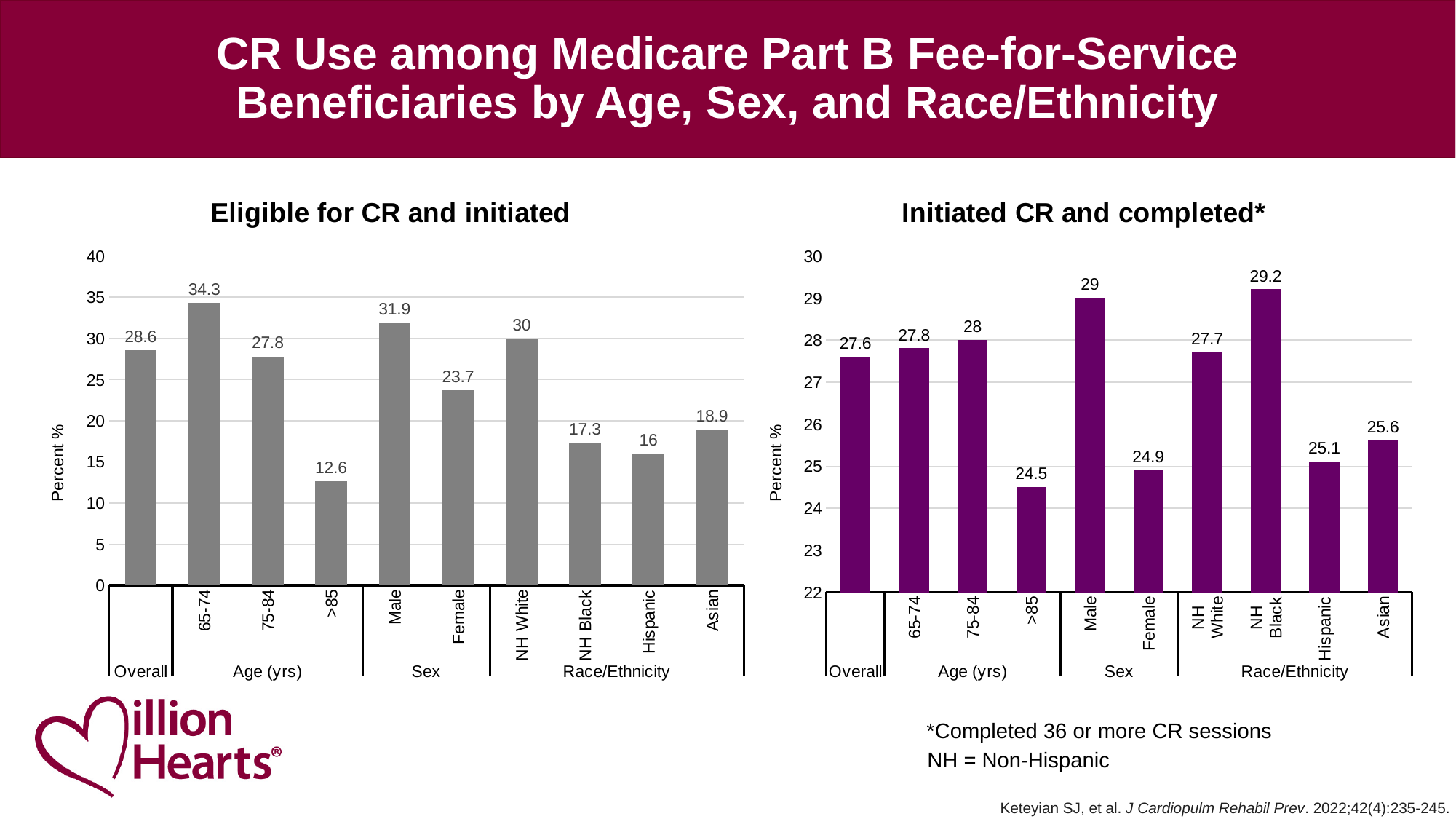
In the 'Eligible for CR and initiated' chart, how many bars are plotted? 10 In the 'Initiated CR and completed*' chart, what is the difference between the NH Black and NH White values? 1.5 In the 'Initiated CR and completed*' chart, is the value for Female greater or less than 25? less In the 'Eligible for CR and initiated' chart, what is the value for Overall? 28.6 In the 'Eligible for CR and initiated' chart, which category has the highest value? 65-74 What kind of chart is the 'Eligible for CR and initiated' chart? Bar chart In the 'Initiated CR and completed*' chart, which category has the lowest value? >85 In the 'Eligible for CR and initiated' chart, what is the difference between the Male and Female values? 8.2 What is the y-axis label on the 'Initiated CR and completed*' chart? Percent % In the 'Eligible for CR and initiated' chart, which category has the lowest value? >85 In the 'Initiated CR and completed*' chart, which is larger, the value for Hispanic or the value for Asian? Asian In the 'Initiated CR and completed*' chart, what is the value for NH Black? 29.2